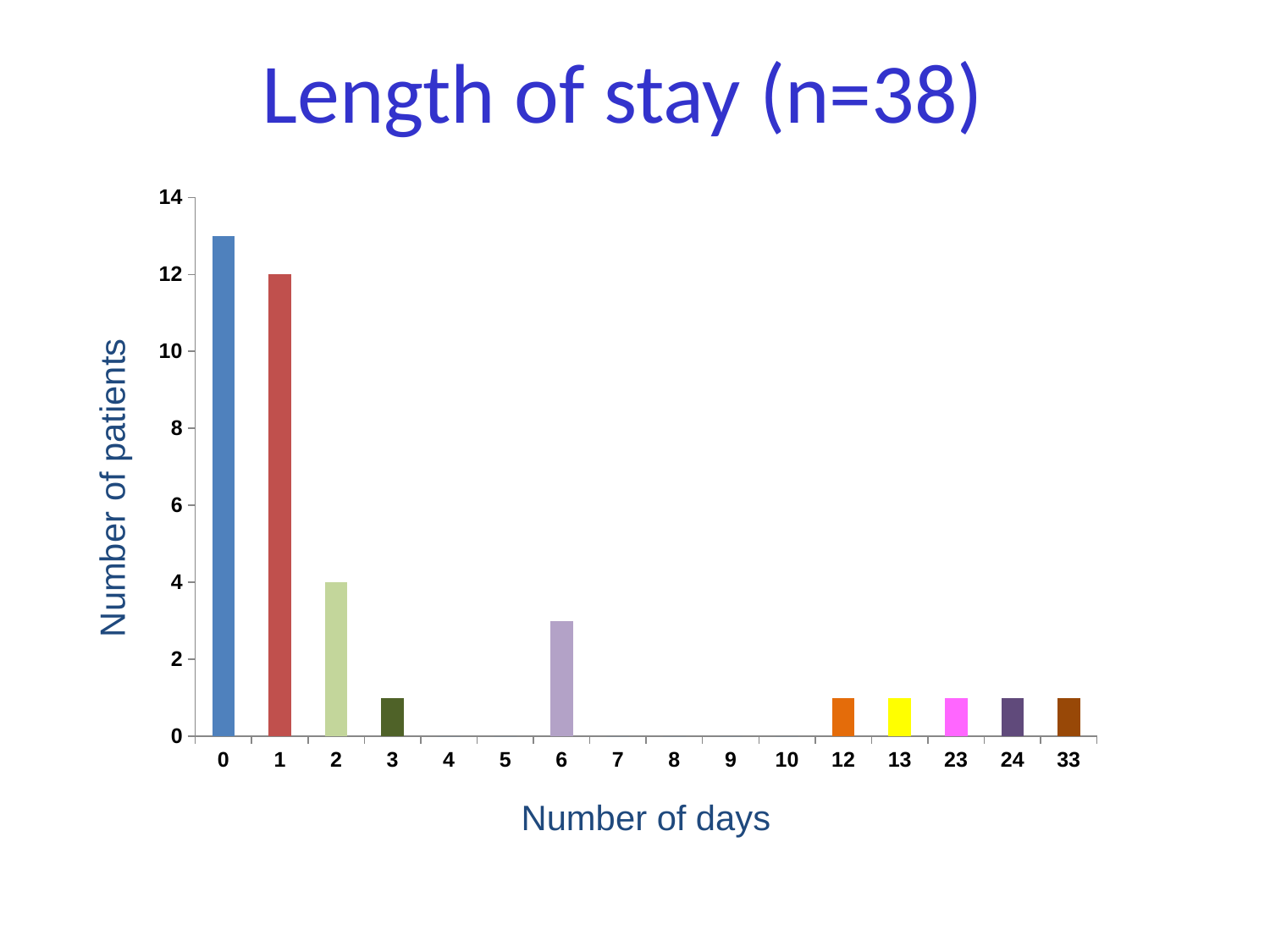
How many patients had a length of stay of 1 day? 12 Which has more patients: 1 day or 2 days? 1 day What kind of chart is shown on the slide? bar chart What is the label of the x axis? Number of days How many patients had a length of stay of 5 days? 0 How many categories are shown on the x axis? 16 What is the title of the chart? Length of stay (n=38) How many patients had a length of stay of 2 days? 4 Is the number of patients for 0 days greater or less than 12? greater Is the number of patients for 3 days greater or less than 2? less Is the number of patients for 6 days greater or less than 2? greater Which number of days has the highest number of patients? 0